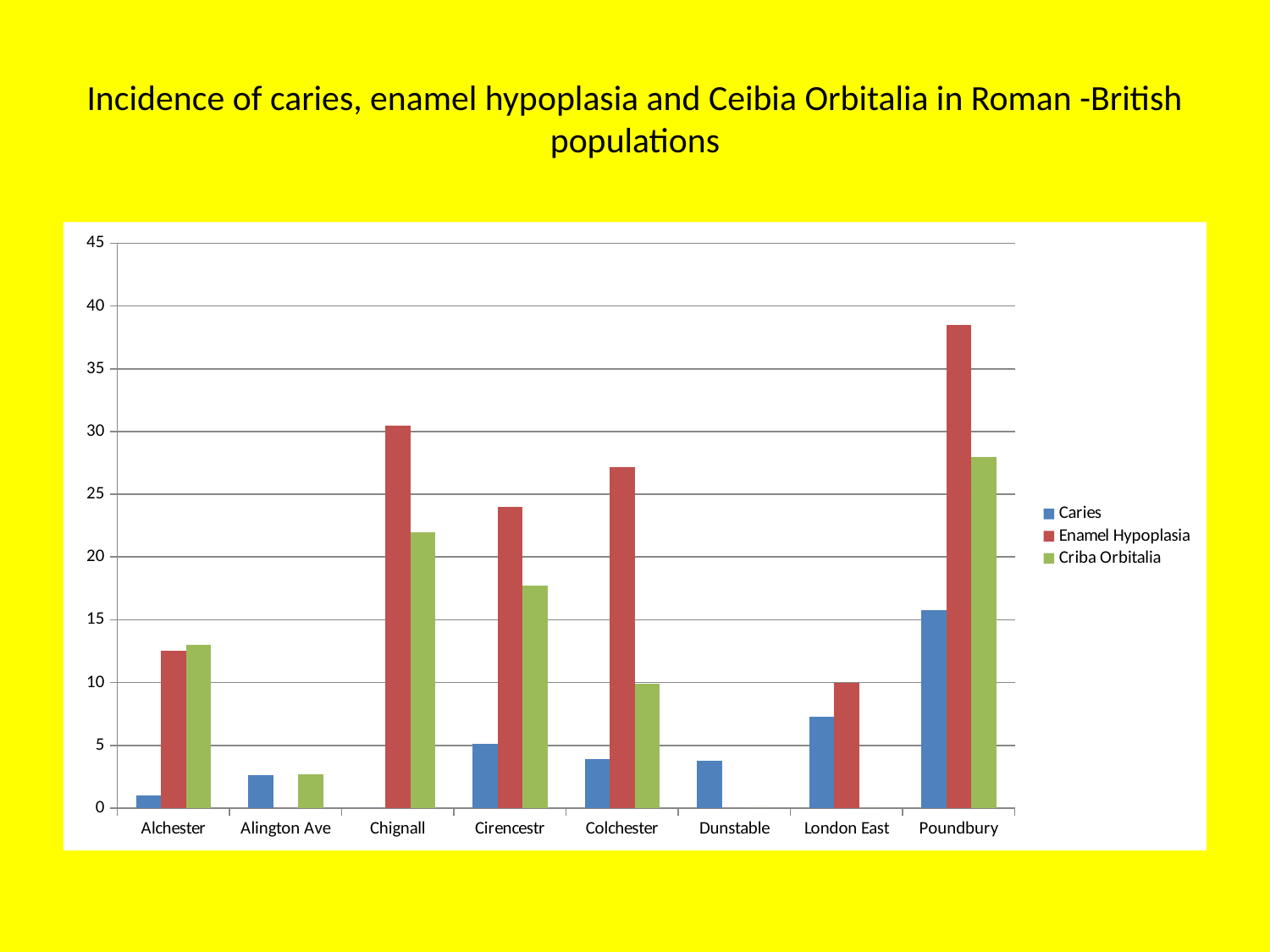
Which is larger, the Enamel Hypoplasia value for Chignall or for Colchester? Chignall Which population has the highest Enamel Hypoplasia value? Poundbury What kind of chart is shown on the slide? bar chart How many populations (categories) are shown on the x axis? 8 Is the Caries value for Dunstable greater or less than 5? less Which population has the highest Criba Orbitalia value? Poundbury Is the Enamel Hypoplasia value for Colchester greater or less than 25? greater Is the Enamel Hypoplasia value for Poundbury greater or less than 35? greater Which population has the highest Caries value? Poundbury How many series does the legend list? 3 What are the three series listed in the legend? Caries, Enamel Hypoplasia, Criba Orbitalia